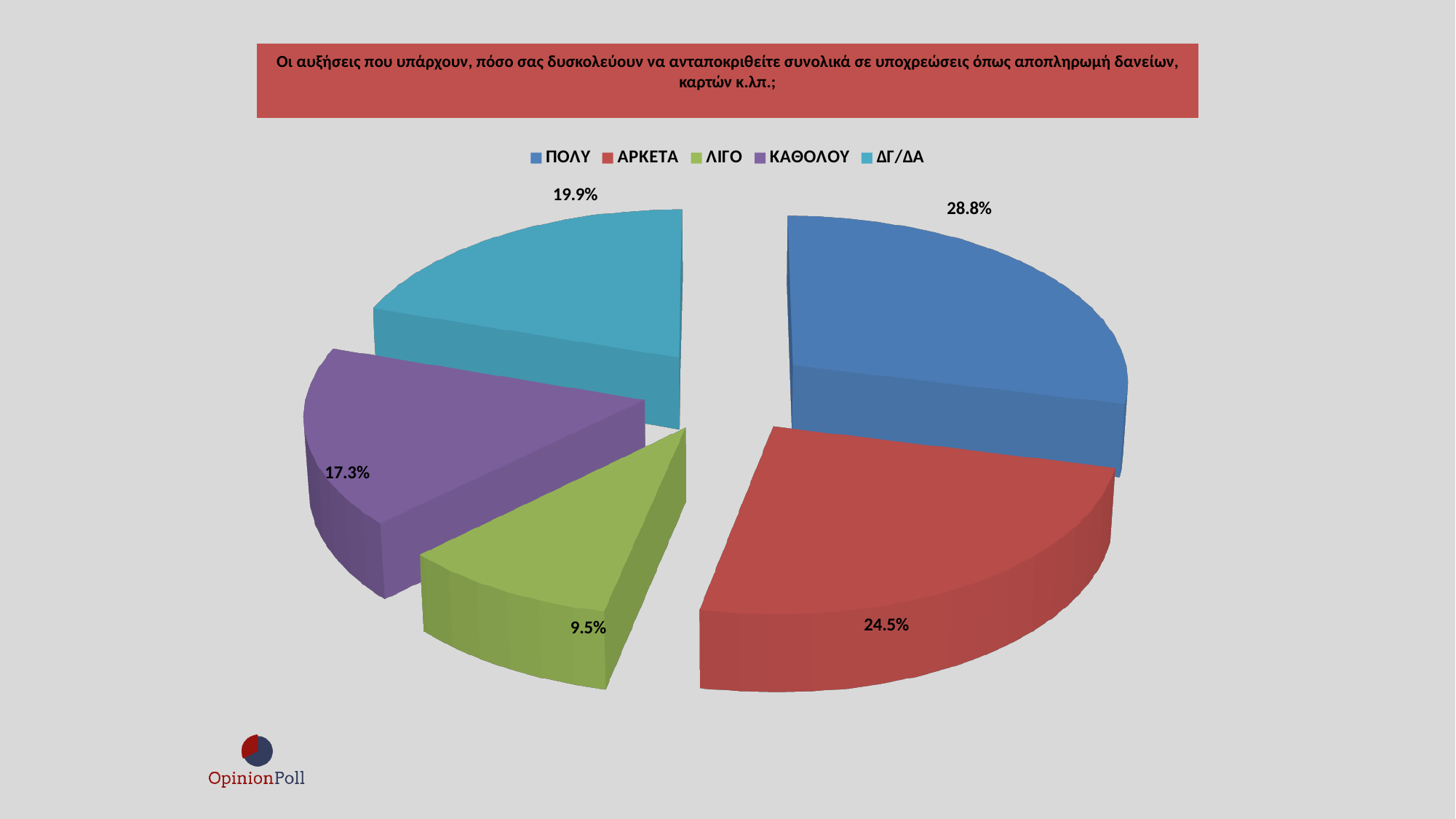
What percentage is shown for ΠΟΛΥ? 28.8% What percentage is shown for ΑΡΚΕΤΑ? 24.5% What colour is the ΛΙΓΟ slice? Green How many categories does the pie chart have? 5 What is the difference between the ΠΟΛΥ and ΑΡΚΕΤΑ percentages? 4.3% What kind of chart is shown on the slide? Pie chart Which category has the largest share of the pie? ΠΟΛΥ Which is larger, the share for ΚΑΘΟΛΟΥ or the share for ΔΓ/ΔΑ? ΔΓ/ΔΑ What percentage is shown for ΚΑΘΟΛΟΥ? 17.3% What percentage is shown for ΛΙΓΟ? 9.5% What percentage is shown for ΔΓ/ΔΑ? 19.9% Which category has the smallest share of the pie? ΛΙΓΟ